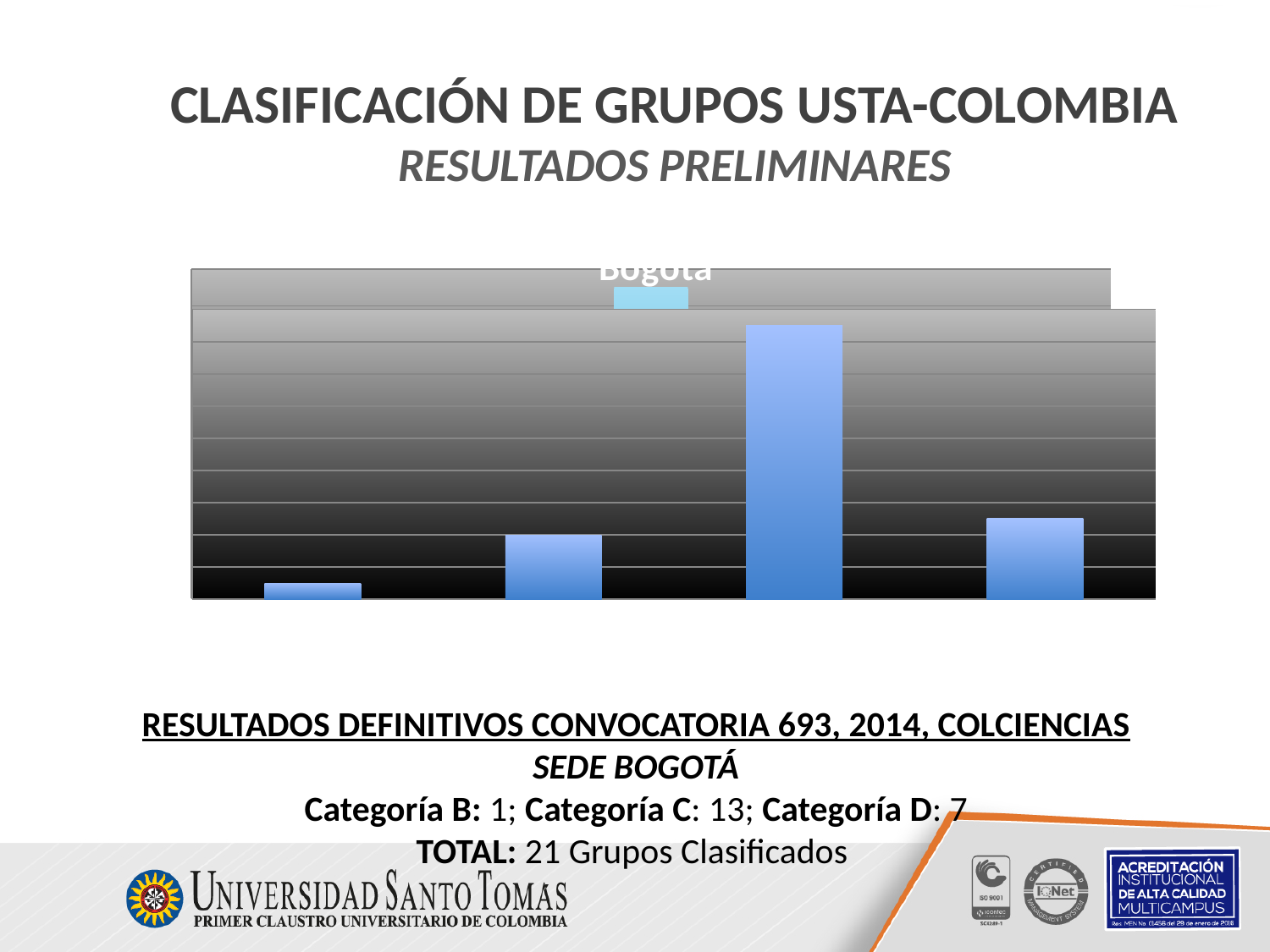
Which bar in the chart is the shortest, counting from the left? the first bar Which is taller in the chart, the second bar from the left or the fourth bar from the left? the fourth bar How many bars are plotted in the chart? 4 What title is shown above the chart? Bogotá What kind of chart is shown on the slide? bar chart Do the bar heights rise steadily from left to right across the chart? no Which is taller in the chart, the first bar from the left or the third bar from the left? the third bar What colour are the bars in the chart? blue Which bar in the chart is the tallest, counting from the left? the third bar